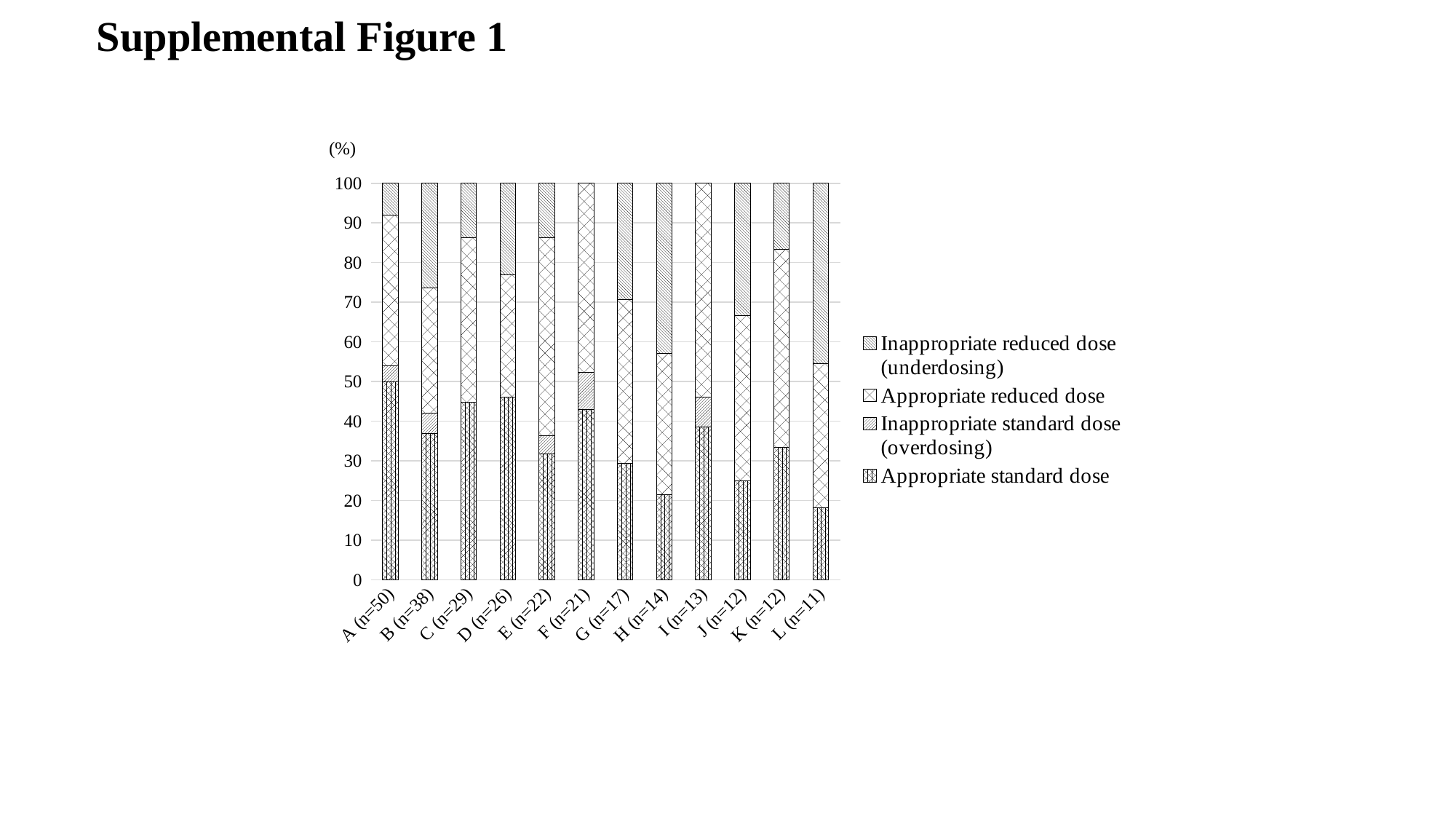
Which category has the largest Appropriate standard dose segment? A (n=50) Which has the larger Appropriate standard dose segment, A (n=50) or H (n=14)? A (n=50) What unit is shown on the y axis of the chart? (%) How many series does the legend list? 4 How many categories (groups A to L) are plotted on the x axis? 12 Which legend entry is listed first (at the top of the legend)? Inappropriate reduced dose (underdosing) Is the Appropriate standard dose value for L (n=11) greater or less than 30? less Is the Appropriate standard dose value for A (n=50) greater or less than 40? greater What is the total height of the stacked bar for A (n=50)? 100 What kind of chart is shown on the slide? Stacked bar chart Is the Appropriate standard dose value for H (n=14) greater or less than 30? less Which has the larger Appropriate standard dose segment, C (n=29) or L (n=11)? C (n=29)